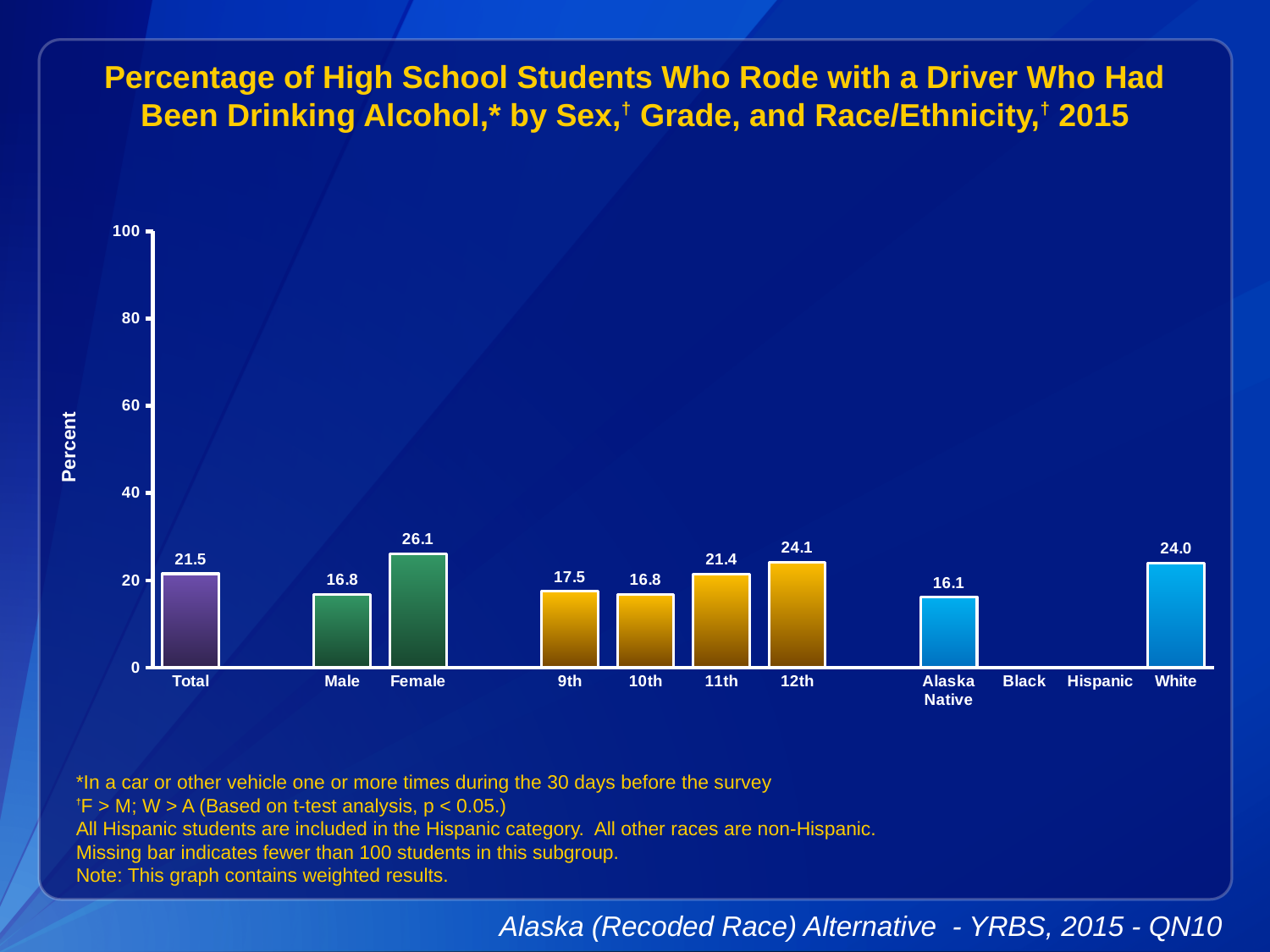
Which category has the highest value? Female Which is larger, the value for 11th grade or the value for 9th grade? 11th grade What is the difference between the Female and Male values? 9.3 Which category has the lowest plotted value? Alaska Native How many categories have a bar plotted? 9 What is the value for Alaska Native? 16.1 What is the value for Female? 26.1 Is the value for White greater or less than 20? greater Which categories on the x axis have no bar shown? Black and Hispanic What kind of chart is shown? Bar chart What is the value for 12th grade? 24.1 What is the value for Total? 21.5